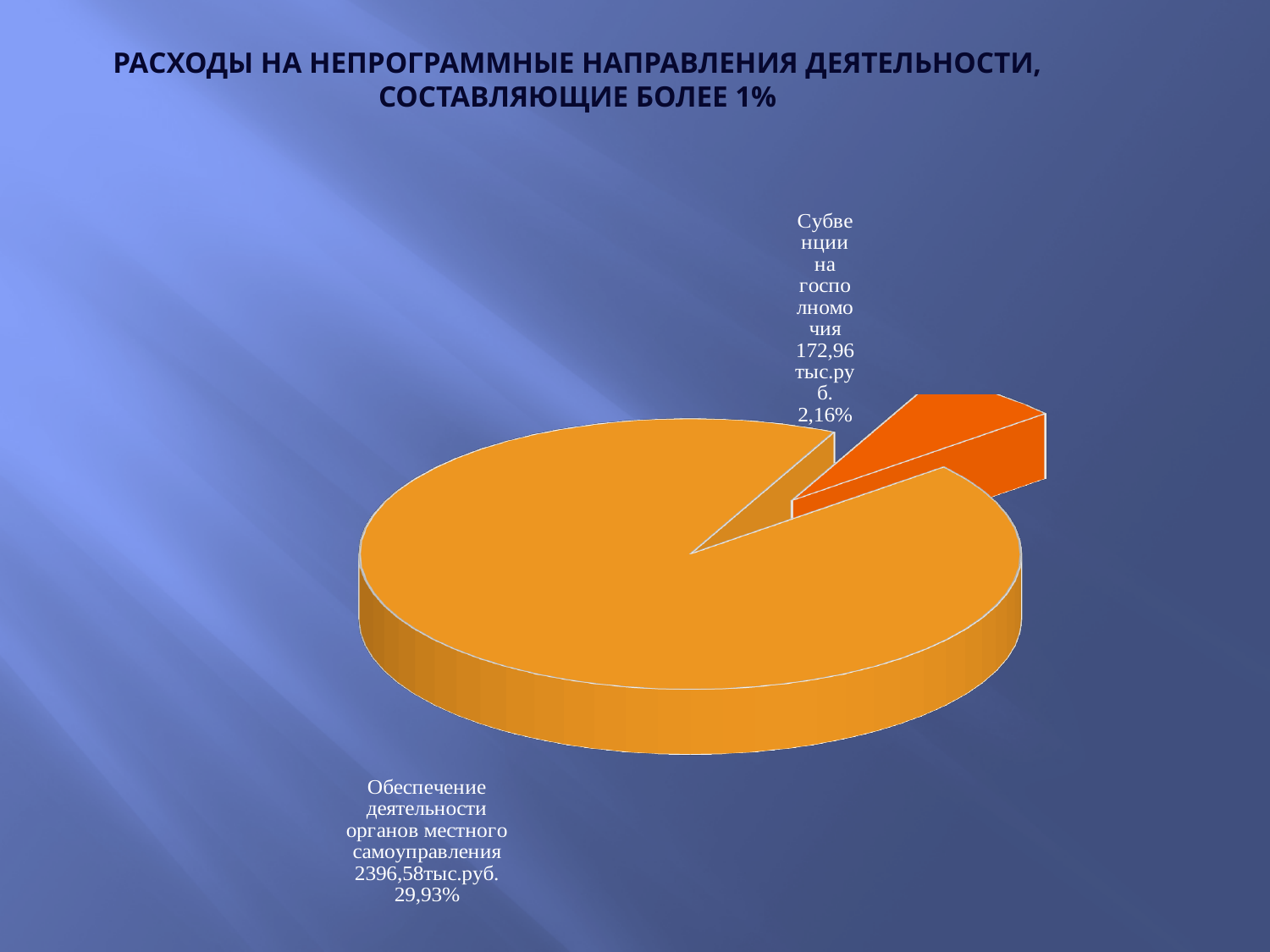
Which is larger: Обеспечение деятельности органов местного самоуправления or Субвенции на госполномочия? Обеспечение деятельности органов местного самоуправления What is the value shown for Обеспечение деятельности органов местного самоуправления? 2396,58тыс.руб. What is the value shown for Субвенции на госполномочия? 172,96 тыс.руб. Which slice of the pie chart is the largest? Обеспечение деятельности органов местного самоуправления What is the title of the chart on the slide? РАСХОДЫ НА НЕПРОГРАММНЫЕ НАПРАВЛЕНИЯ ДЕЯТЕЛЬНОСТИ, СОСТАВЛЯЮЩИЕ БОЛЕЕ 1% Which slice of the pie chart is the smallest? Субвенции на госполномочия What kind of chart is shown on the slide? Pie chart How many slices does the pie chart have? 2 What percentage is shown for Субвенции на госполномочия? 2,16% What is the difference in thousand rubles between Обеспечение деятельности органов местного самоуправления and Субвенции на госполномочия? 2223,62 тыс.руб. What percentage is shown for Обеспечение деятельности органов местного самоуправления? 29,93% Which slice is pulled out (exploded) from the pie chart? Субвенции на госполномочия